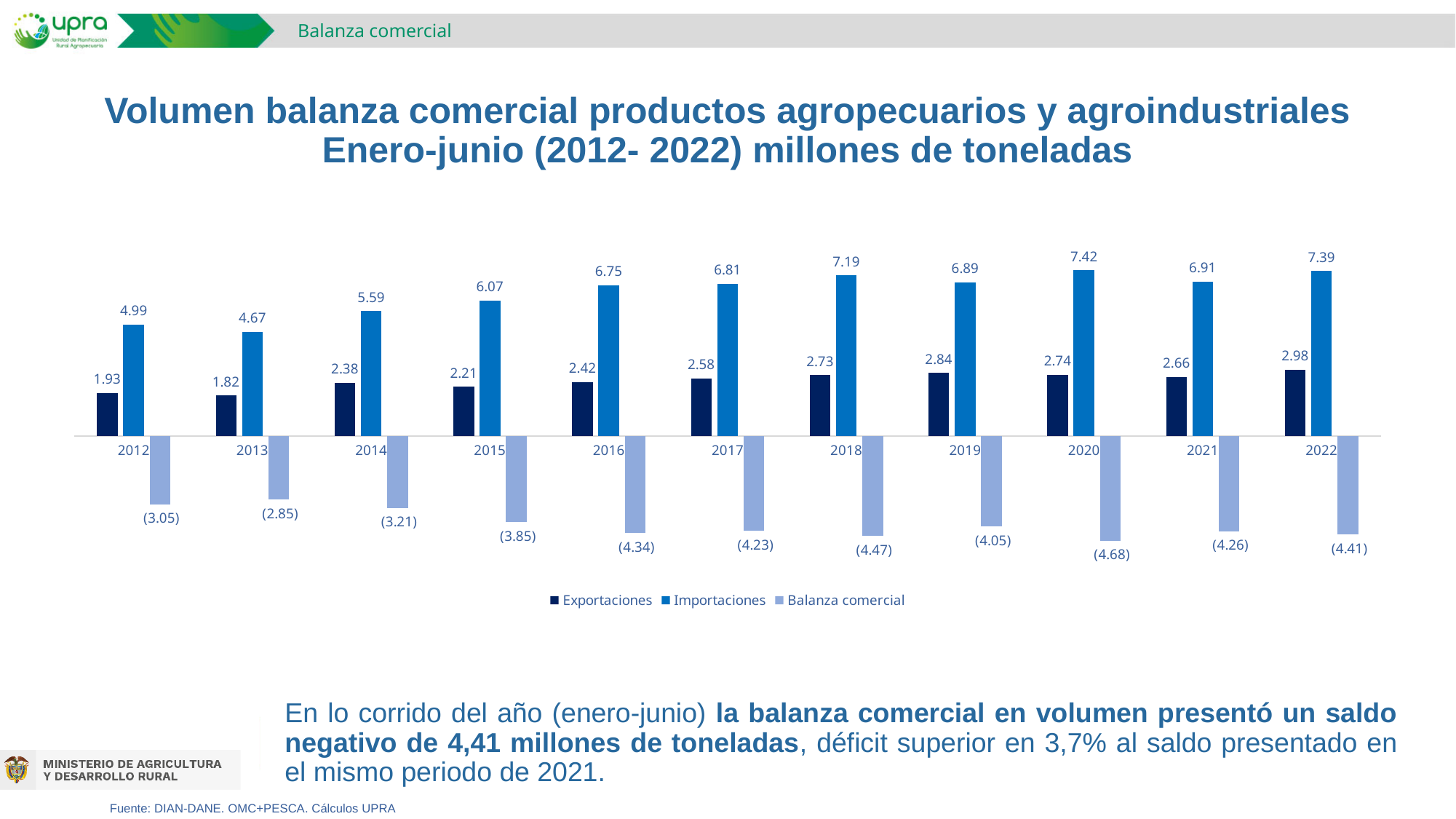
What kind of chart is shown on the slide? Bar chart What is the value of Importaciones for 2020? 7.42 What is the value of Exportaciones for 2013? 1.82 By how much did Importaciones in 2020 exceed Importaciones in 2012? 2.43 What is the Balanza comercial value shown for 2022? (4.41) Do Importaciones values rise or fall from 2012 to 2016? Rise In which year is Importaciones highest? 2020 How many years are shown on the x axis? 11 What is the difference between Importaciones and Exportaciones in 2022? 4.41 How many series does the legend list? 3 In which year is Exportaciones lowest? 2013 Which is larger, Exportaciones in 2019 or Exportaciones in 2020? 2019